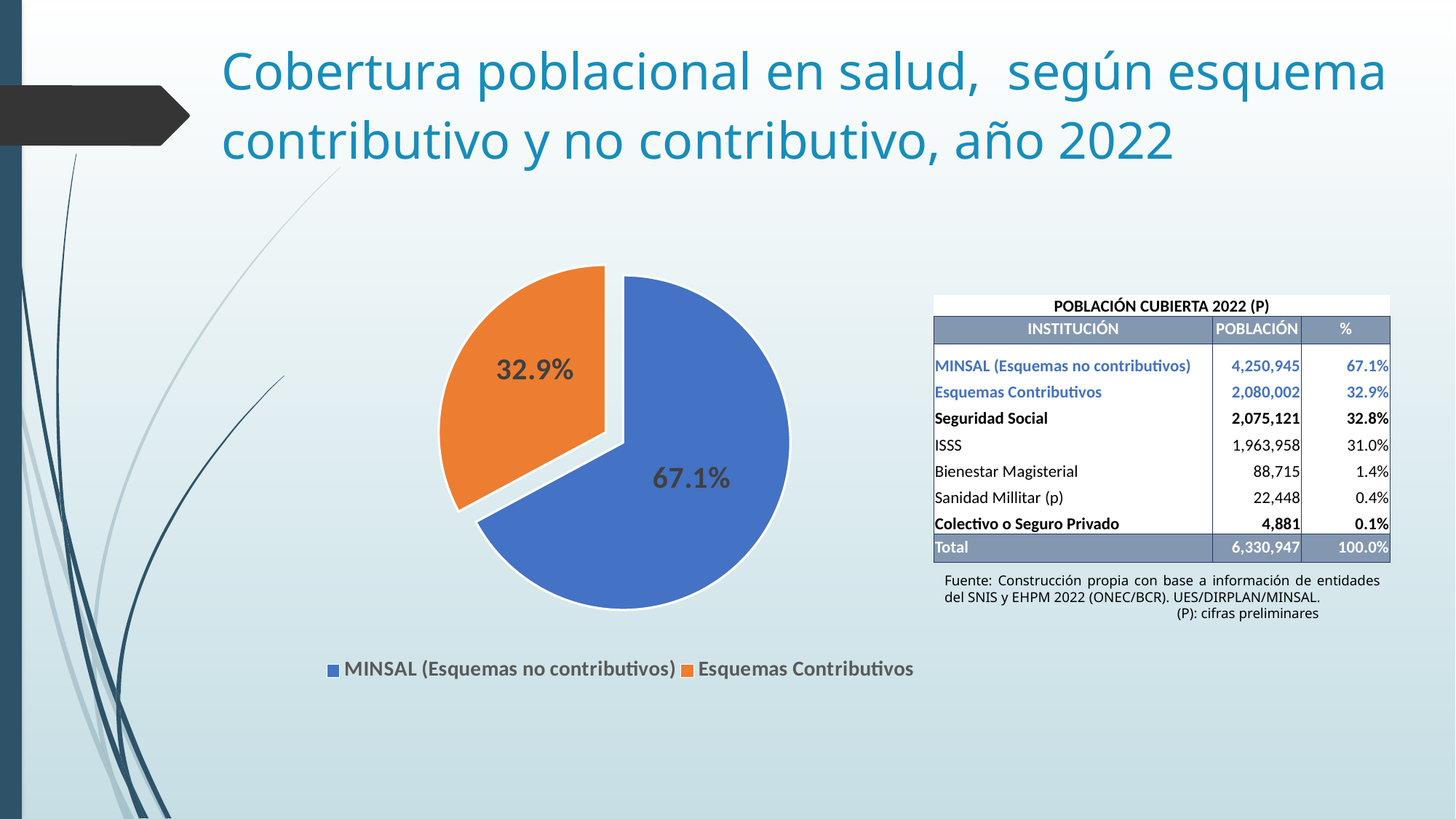
Which slice of the pie chart is the smallest? Esquemas Contributivos What share of the pie does Esquemas Contributivos represent? 32.9% What is the difference in percentage points between the MINSAL (Esquemas no contributivos) slice and the Esquemas Contributivos slice? 34.2 percentage points How many slices does the pie chart have? 2 What share of the pie does MINSAL (Esquemas no contributivos) represent? 67.1% What kind of chart is shown on the slide? pie chart What colour is the MINSAL (Esquemas no contributivos) slice in the pie chart? blue What colour is the Esquemas Contributivos slice in the pie chart? orange How many entries does the legend of the pie chart list? 2 Which slice of the pie chart is the largest? MINSAL (Esquemas no contributivos) Which is larger in the pie chart: MINSAL (Esquemas no contributivos) or Esquemas Contributivos? MINSAL (Esquemas no contributivos)